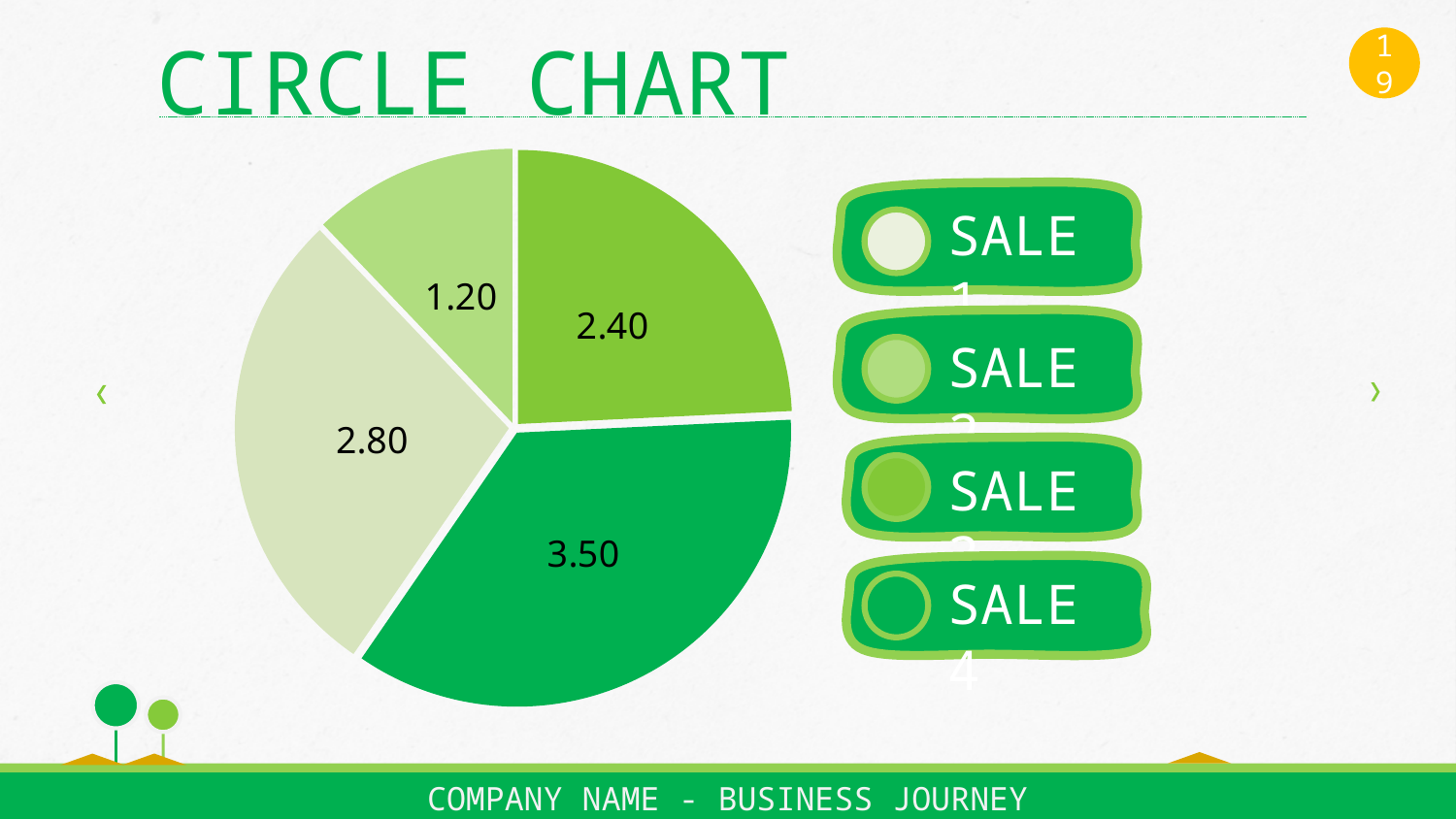
What is the value of the palest slice in the pie chart? 2.80 What is the value of the darkest green slice in the pie chart? 3.50 What is the title of the slide containing the pie chart? CIRCLE CHART Which is larger, the slice labelled 2.40 or the slice labelled 2.80? 2.80 What is the value of the largest slice in the pie chart? 3.50 What is the total of all the slice values in the pie chart? 9.90 What is the difference between the slice labelled 2.80 and the slice labelled 1.20? 1.60 What kind of chart is shown on the slide? pie chart How many slices does the pie chart have? 4 How many entries does the legend next to the pie chart list? 4 What is the value of the smallest slice in the pie chart? 1.20 What is the difference between the largest slice (3.50) and the slice labelled 2.40? 1.10